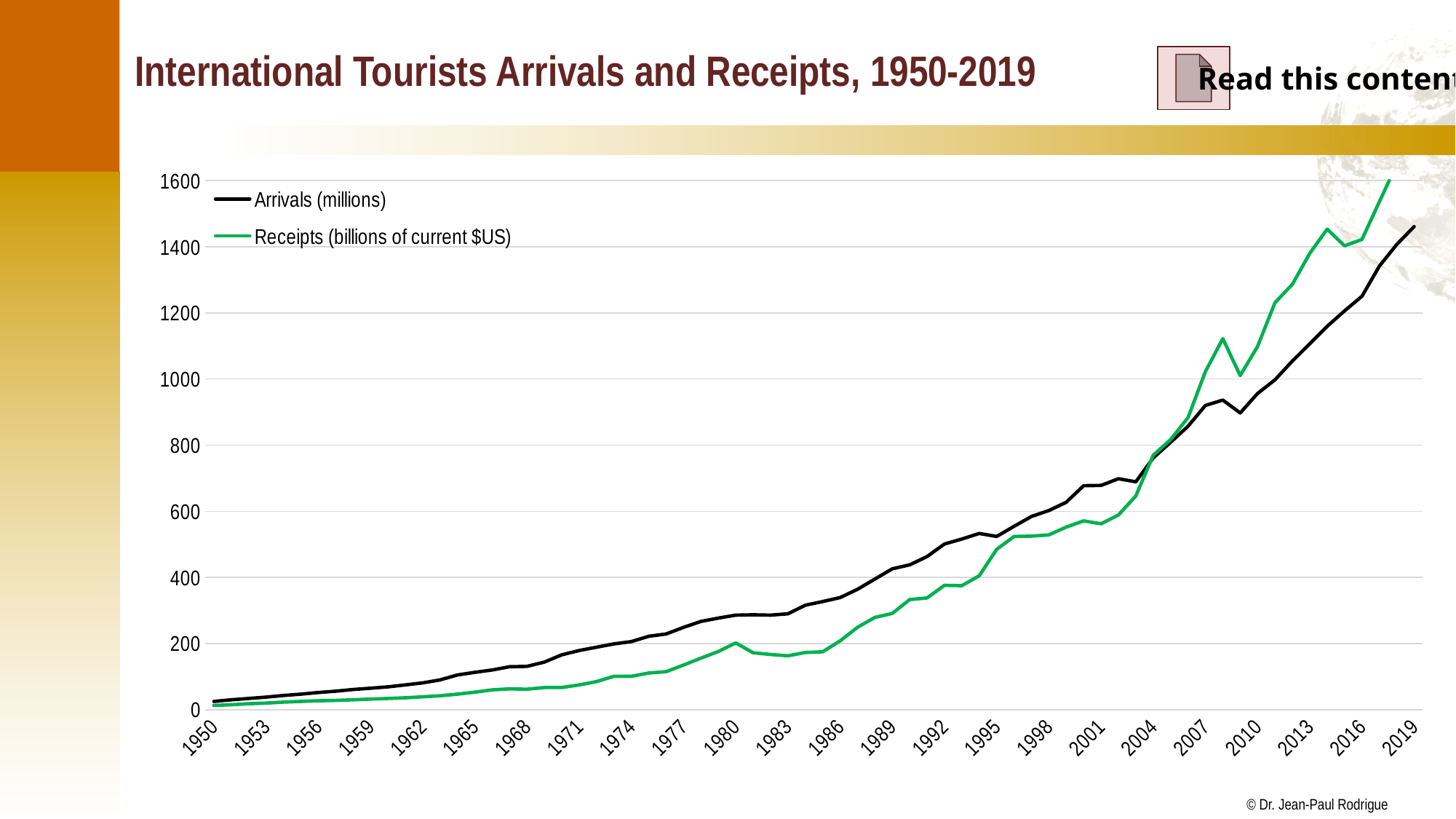
Is the value for Arrivals (millions) in 2019 greater or less than 1400? greater Which colour is used for the Receipts (billions of current $US) line? green Is the value for Arrivals (millions) in 1950 greater or less than 200? less Is the value for Arrivals (millions) in 2010 greater or less than 1000? less Overall, do the Arrivals (millions) values rise or fall from 1950 to 2019? rise What kind of chart is shown on the slide? line chart How many series does the legend list? 2 What is the title of the chart? International Tourists Arrivals and Receipts, 1950-2019 In 1980, which series has the higher value, Arrivals (millions) or Receipts (billions of current $US)? Arrivals (millions) In which year does the Arrivals (millions) series reach its highest value? 2019